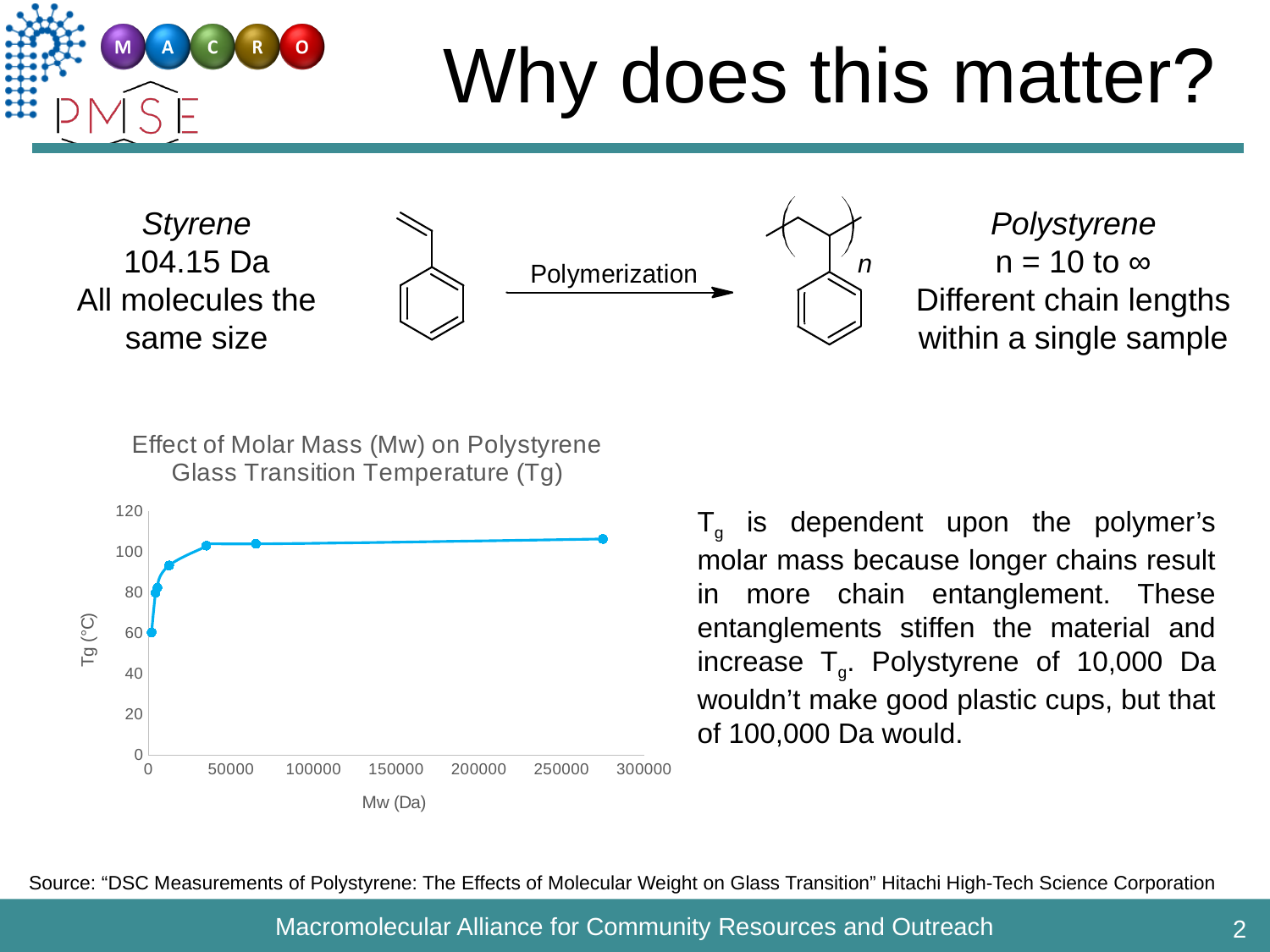
Is the Tg value at the lowest plotted Mw greater or less than 40? greater What is the title of the chart? Effect of Molar Mass (Mw) on Polystyrene Glass Transition Temperature (Tg) What is the maximum value shown on the y axis? 120 Which plotted point has the lowest Tg? the point at the smallest Mw Does Tg rise or fall as Mw increases along the x axis? rise Is the Tg value at the lowest plotted Mw greater or less than 80? less What kind of chart is shown on the slide? line chart What is the label of the y axis of the chart? Tg (°C) Which is larger, the Tg at the smallest Mw or the Tg at the largest Mw? the Tg at the largest Mw